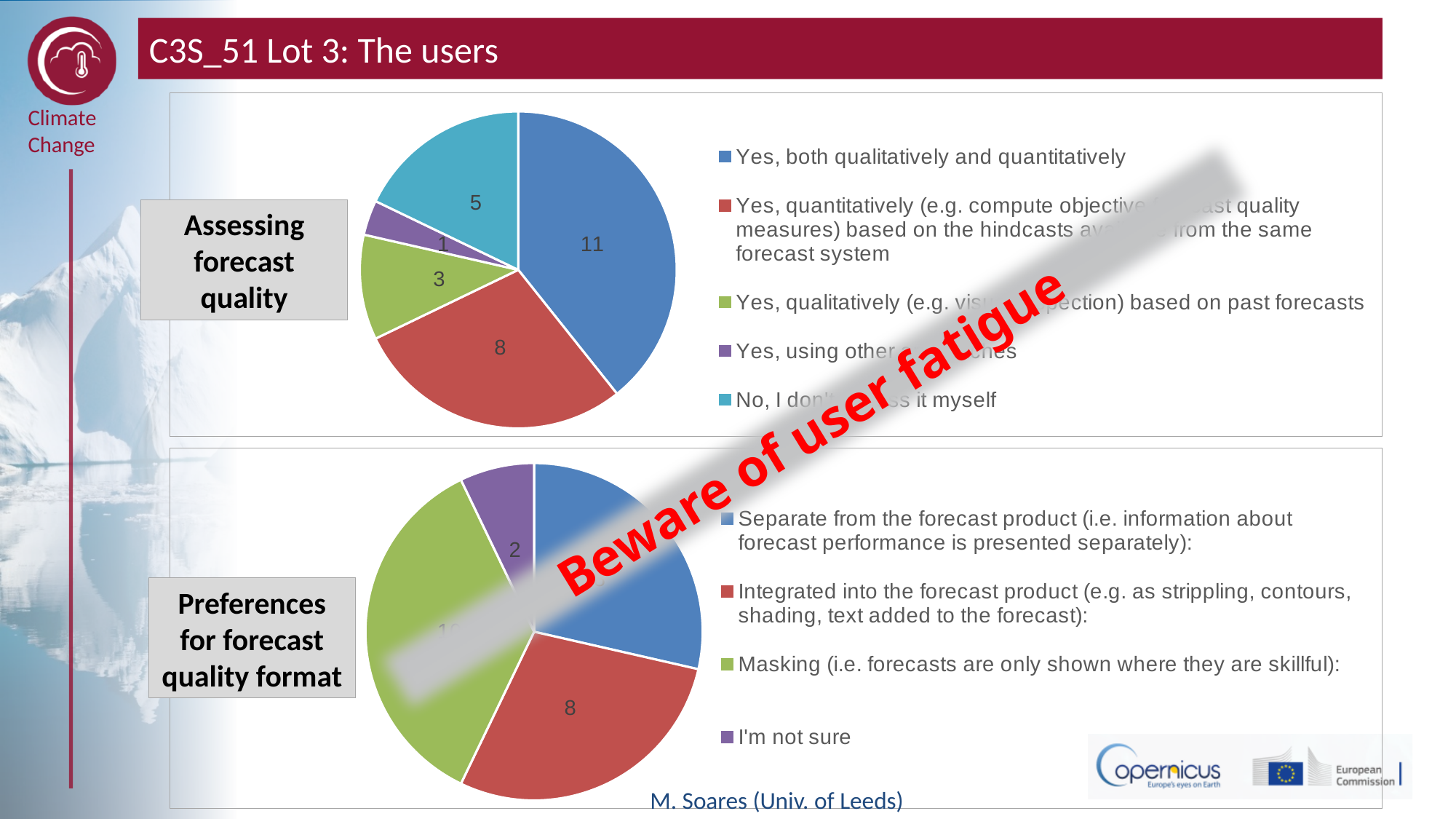
In the 'Assessing forecast quality' pie chart, what is the smallest value shown? 1 In the 'Assessing forecast quality' pie chart, what is the total of all slice values? 28 In the 'Preferences for forecast quality format' pie chart, what is the value for 'I'm not sure'? 2 In the 'Assessing forecast quality' pie chart, which category has the largest value? Yes, both qualitatively and quantitatively In the 'Preferences for forecast quality format' pie chart, which category has the smallest slice? I'm not sure In the 'Assessing forecast quality' pie chart, what is the value for 'Yes, qualitatively (e.g. visual inspection) based on past forecasts'? 3 In the 'Assessing forecast quality' pie chart, what is the value of the red slice? 8 In the 'Preferences for forecast quality format' pie chart, what is the value for 'Integrated into the forecast product'? 8 In the 'Assessing forecast quality' pie chart, how many categories does the legend list? 5 What type of chart is used in the 'Assessing forecast quality' panel? pie chart In the 'Assessing forecast quality' pie chart, what is the value for 'Yes, both qualitatively and quantitatively'? 11 In the 'Assessing forecast quality' pie chart, what is the difference between the blue slice (11) and the red slice (8)? 3